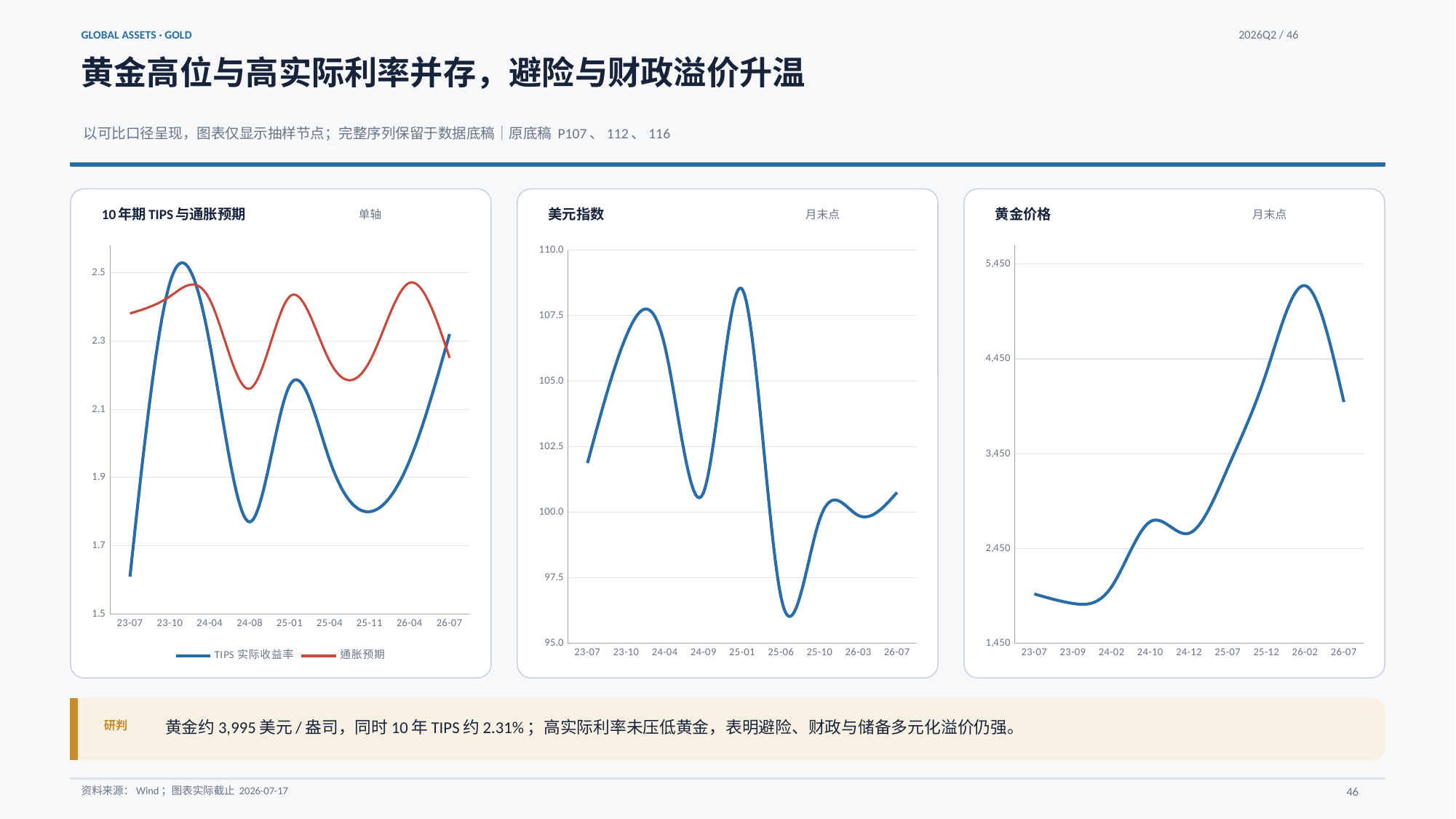
On the 美元指数 chart, is the value at 25-01 greater or less than 107.5? greater How many series does the legend of the 10年期 TIPS 与通胀预期 chart list? 2 What kind of chart is the 美元指数 chart? line chart On the 黄金价格 chart, is the value at 23-07 greater or less than 2,450? less On the 美元指数 chart, is the value at 25-06 greater or less than 97.5? less How many x-axis points are shown on the 黄金价格 chart? 9 On the 美元指数 chart, at which x-axis point is the value lowest? 25-06 What are the two series named in the legend of the 10年期 TIPS 与通胀预期 chart? TIPS 实际收益率 and 通胀预期 On the 黄金价格 chart, does the value overall rise or fall from 23-07 to 26-07? rise On the 黄金价格 chart, at which x-axis point is the value highest? 26-02